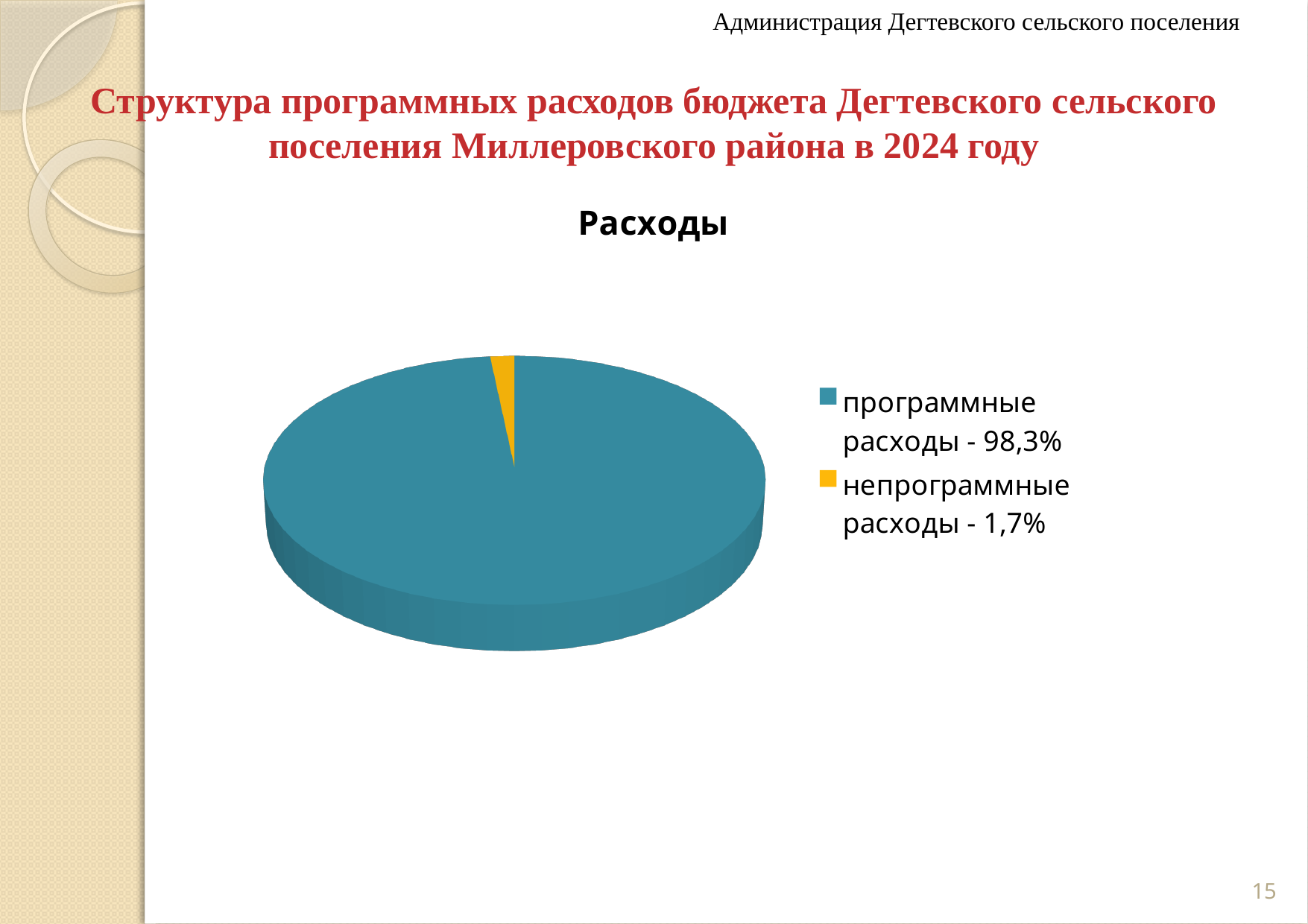
What share of the pie is 'непрограммные расходы'? 1,7% What is the difference in percentage points between 'программные расходы' and 'непрограммные расходы'? 96,6 What colour is the slice for 'непрограммные расходы'? Yellow How many entries does the legend list? 2 How many slices does the pie chart have? 2 Which category has the smallest slice of the pie? непрограммные расходы Which category has the largest slice of the pie? программные расходы What kind of chart is shown on the slide? Pie chart What is the title of the chart? Расходы Which is larger: 'программные расходы' or 'непрограммные расходы'? программные расходы What share of the pie is 'программные расходы'? 98,3%